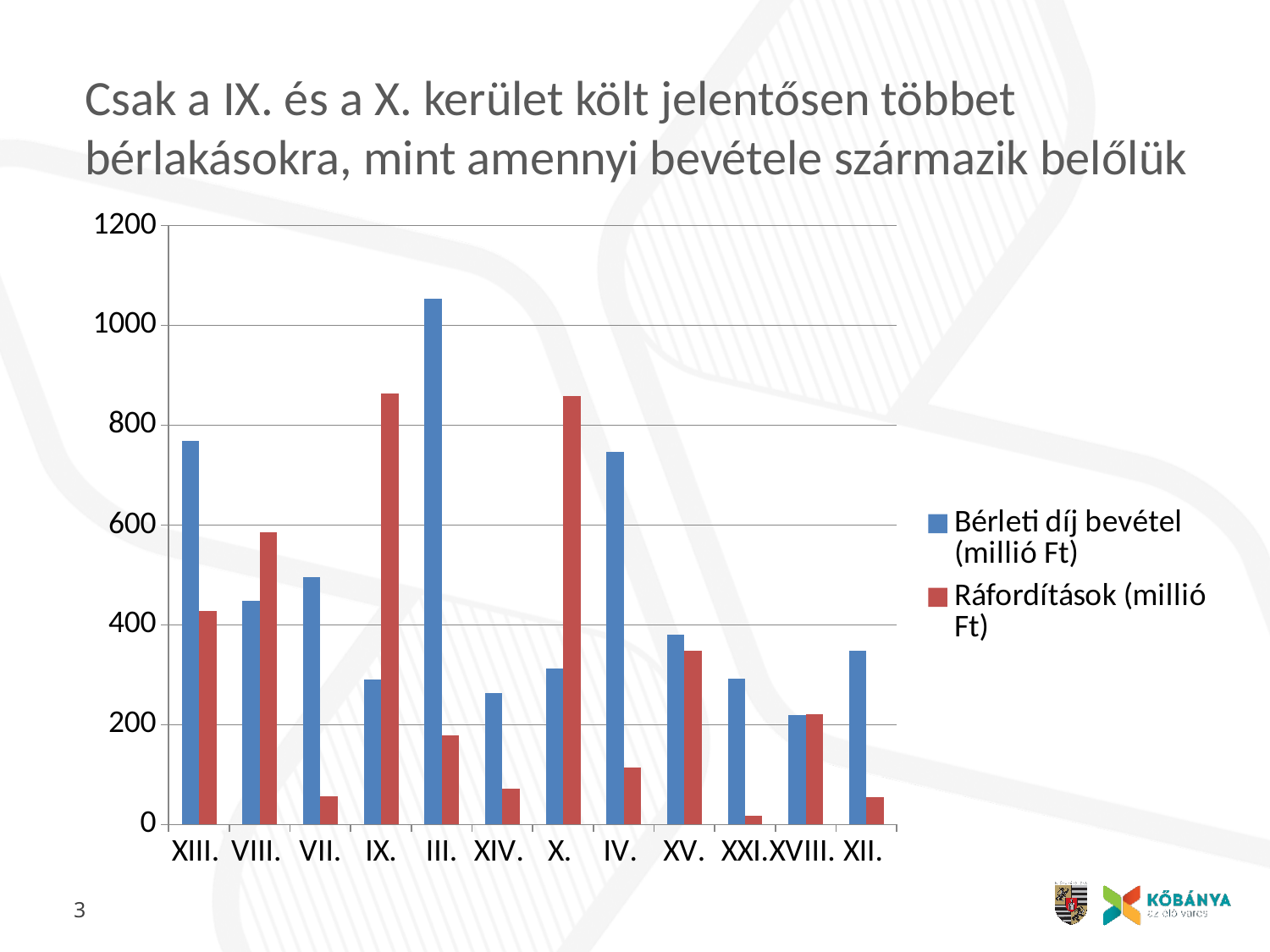
Which district has the lowest Ráfordítások (millió Ft)? XXI. Which district has the lowest Bérleti díj bevétel (millió Ft)? XVIII. Is the Ráfordítások (millió Ft) value for IX. greater or less than 800? greater Is the Bérleti díj bevétel (millió Ft) value for III. greater or less than 1000? greater How many districts (categories) are shown on the x axis? 12 How many series does the legend list? 2 Is the Ráfordítások (millió Ft) value for VII. greater or less than 200? less Which district has the highest Bérleti díj bevétel (millió Ft)? III. What kind of chart is shown on the slide? bar chart For district VIII., which is larger: Bérleti díj bevétel (millió Ft) or Ráfordítások (millió Ft)? Ráfordítások (millió Ft) Which colour represents the Ráfordítások (millió Ft) series? red